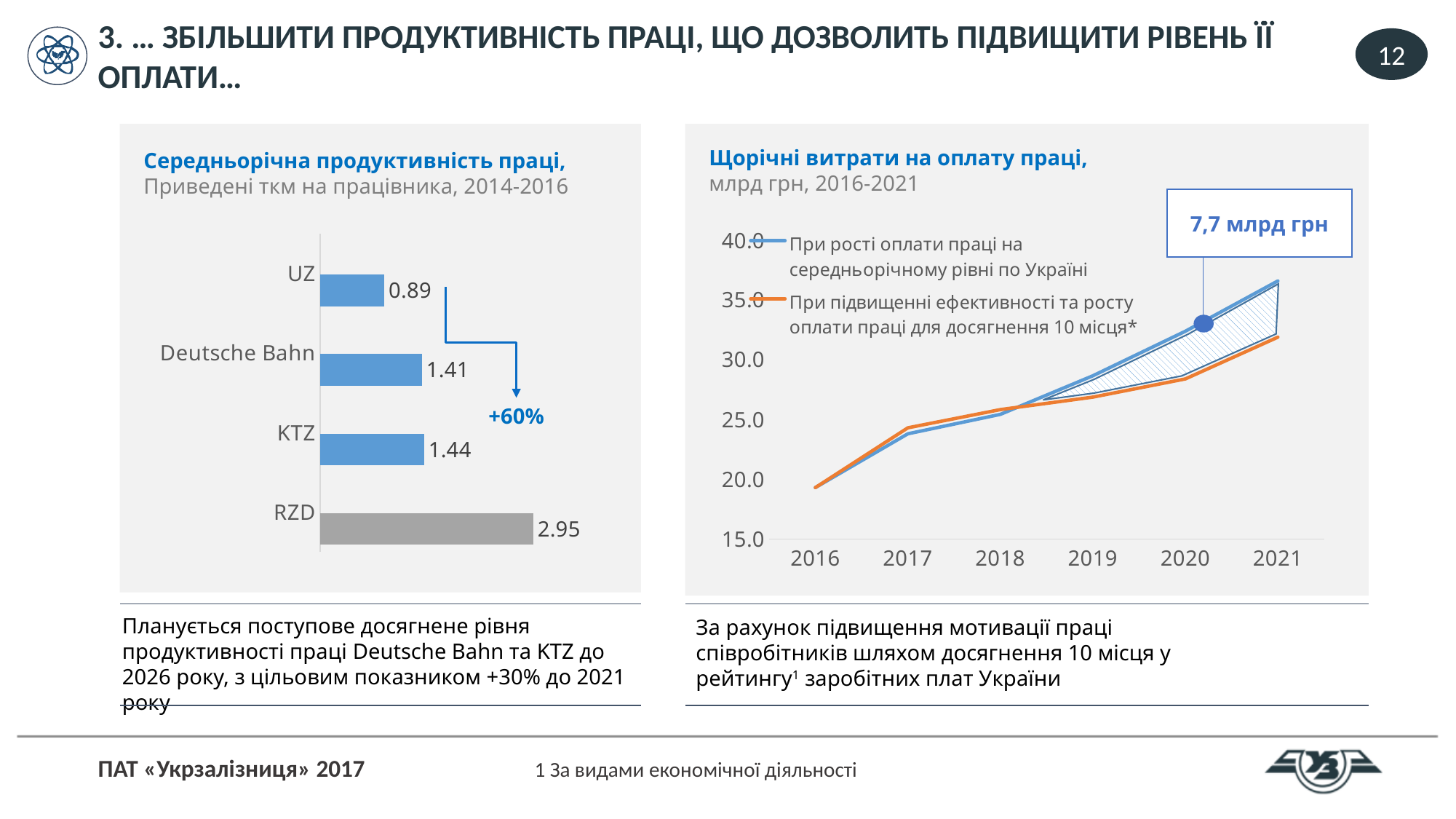
In the right chart (Щорічні витрати на оплату праці), which series has the larger value in 2021, the blue or the orange one? The blue series What kind of chart is the left chart (Середньорічна продуктивність праці)? Bar chart In the left chart (Середньорічна продуктивність праці), what is the value for Deutsche Bahn? 1.41 In the left chart (Середньорічна продуктивність праці), which category has the highest value? RZD In the left chart (Середньорічна продуктивність праці), how many categories are shown? 4 In the left chart (Середньорічна продуктивність праці), what is the value for UZ? 0.89 In the left chart (Середньорічна продуктивність праці), what is the difference between the values for RZD and UZ? 2.06 In the left chart (Середньорічна продуктивність праці), which category has the lowest value? UZ In the left chart (Середньорічна продуктивність праці), what is the value for RZD? 2.95 In the right chart (Щорічні витрати на оплату праці), do the values of the blue series rise or fall from 2016 to 2021? Rise In the right chart (Щорічні витрати на оплату праці), how many series does the legend list? 2 In the right chart (Щорічні витрати на оплату праці), is the 2016 value of the blue series greater or less than 25.0? less